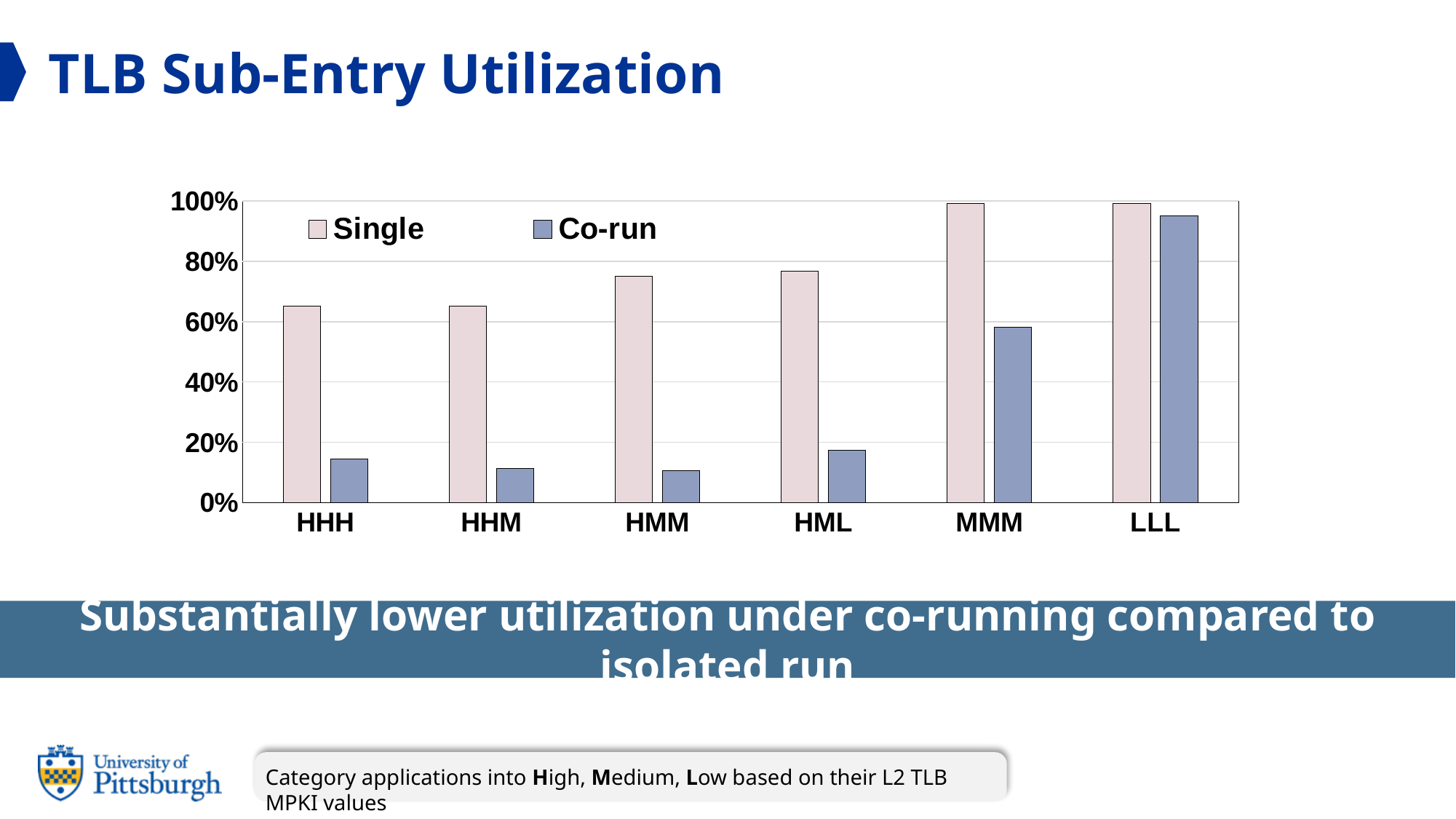
For HHH, which is larger: the Single value or the Co-run value? Single Is the Co-run value for LLL greater or less than 80%? greater Which category has the highest Co-run value? LLL How many series does the legend list? 2 Is the Single value for HML greater or less than 80%? less What kind of chart is shown on the slide? bar chart What are the two series named in the legend? Single and Co-run Which is larger: the Co-run value for MMM or the Co-run value for HML? MMM How many categories are shown on the x axis? 6 Is the Co-run value for HHH greater or less than 20%? less